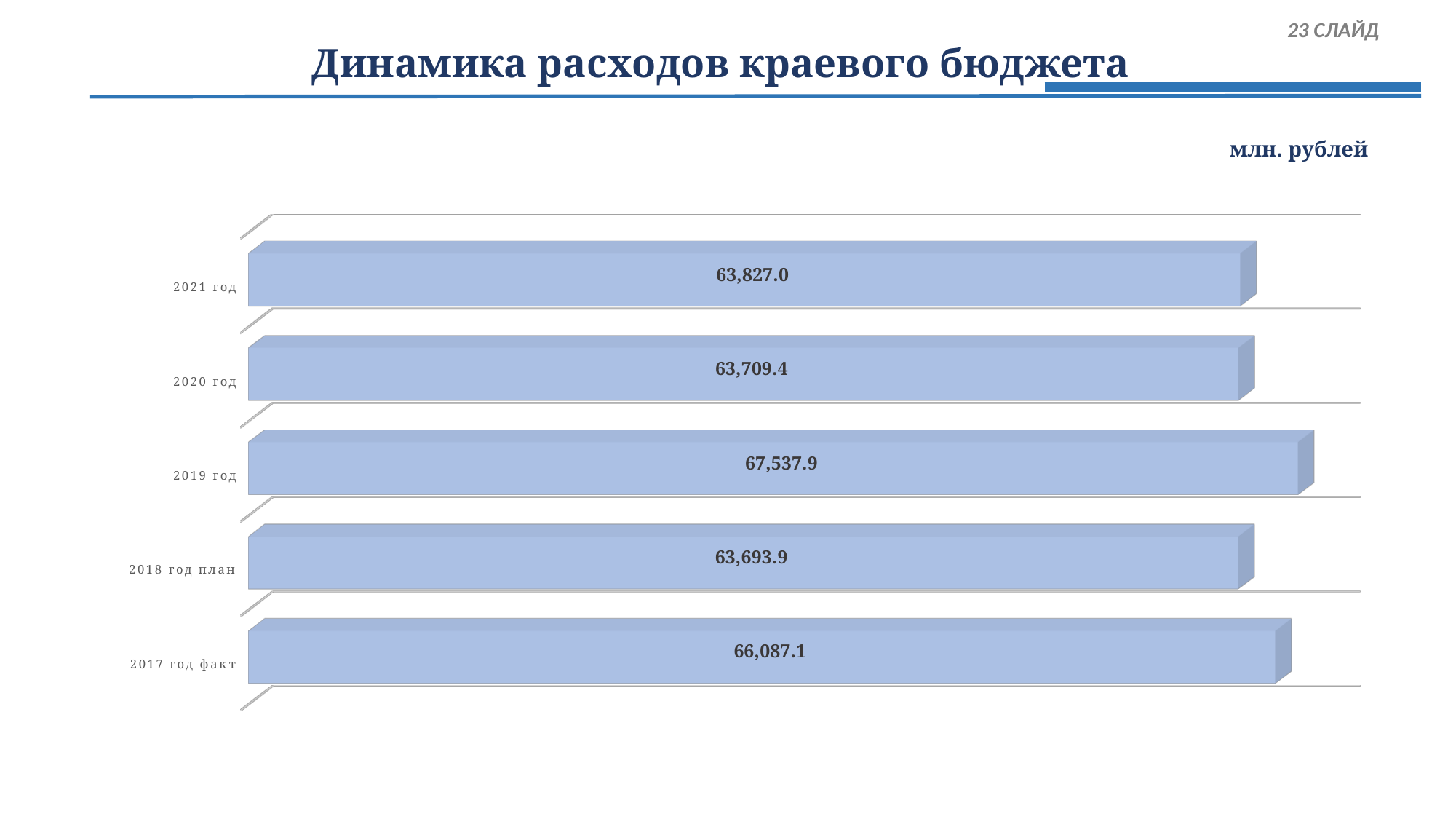
What is the difference between the values for 2019 год and 2017 год факт? 1,450.8 Which is larger, the value for 2019 год or the value for 2017 год факт? 2019 год Which category has the highest value? 2019 год What is the value for 2021 год? 63,827.0 What kind of chart is shown on the slide? Bar chart How many categories are shown in the chart? 5 Which category has the lowest value? 2018 год план What is the title of the chart? Динамика расходов краевого бюджета What is the value for 2018 год план? 63,693.9 What is the value for 2017 год факт? 66,087.1 What is the value for 2019 год? 67,537.9 What is the difference between the values for 2021 год and 2020 год? 117.6